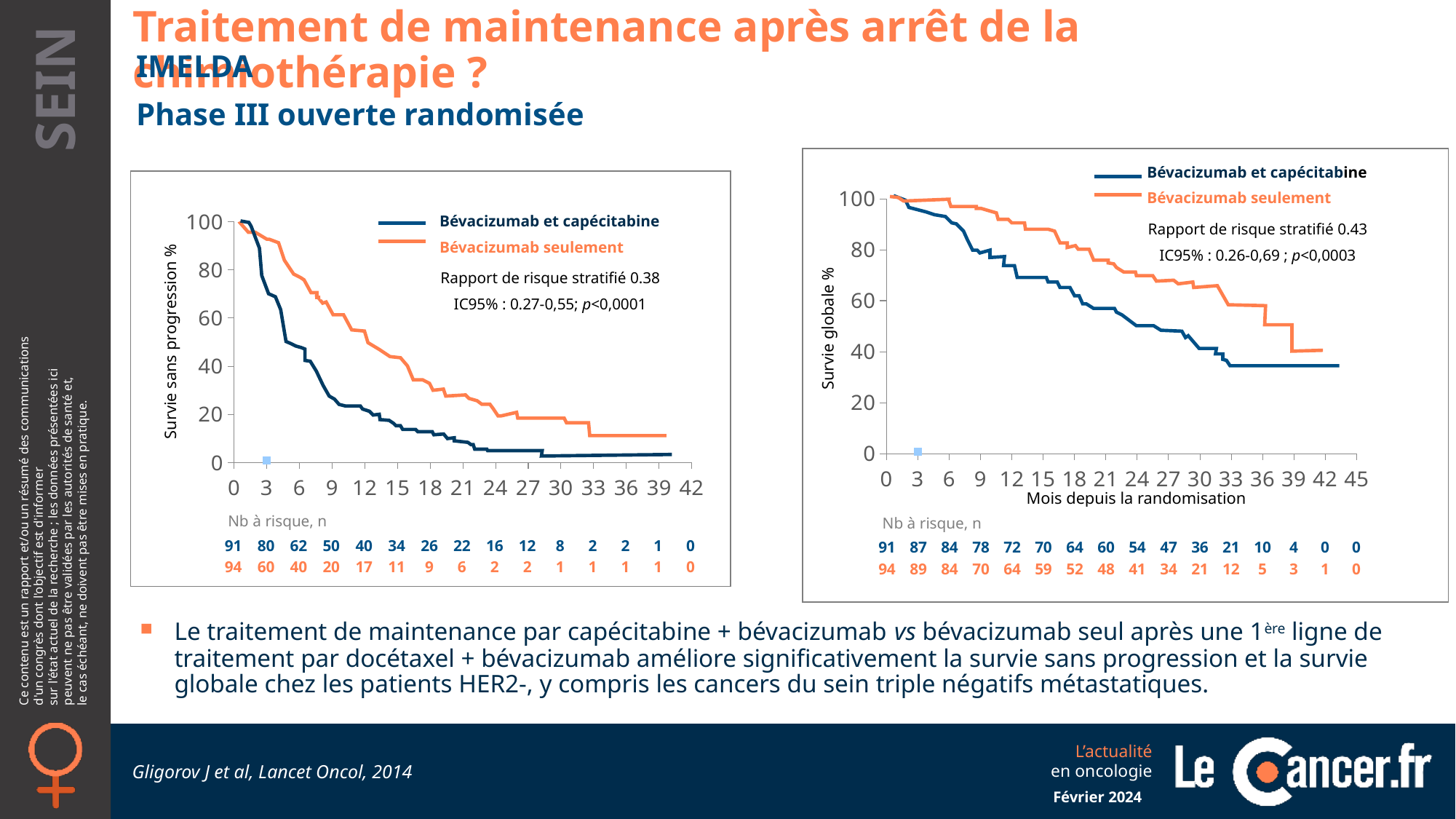
How many time points are listed in the 'Nb à risque' table of the right chart (Survie globale %)? 16 What kind of chart is the left chart (Survie sans progression %)? line chart In the left chart (Survie sans progression %), what is the number at risk for Bévacizumab et capécitabine at 3 months? 80 In the right chart (Survie globale %), what is the difference between the numbers at risk of the two groups at 3 months? 2 In the right chart (Survie globale %), is the value of the Bévacizumab seulement curve at 24 months greater or less than 60? greater In the right chart (Survie globale %), do the survival curves rise or fall as months since randomisation increase? fall In the right chart (Survie globale %), what is the number at risk for Bévacizumab et capécitabine at 12 months? 72 In the left chart (Survie sans progression %), what is the number at risk for Bévacizumab seulement at 6 months? 40 In the left chart (Survie sans progression %), which group has the larger number at risk at 9 months? Bévacizumab et capécitabine How many series does the legend of the right chart (Survie globale %) list? 2 What stratified hazard ratio (Rapport de risque stratifié) is shown on the left chart (Survie sans progression %)? 0.38 In the left chart (Survie sans progression %), is the value of the Bévacizumab et capécitabine curve at 12 months greater or less than 40? less